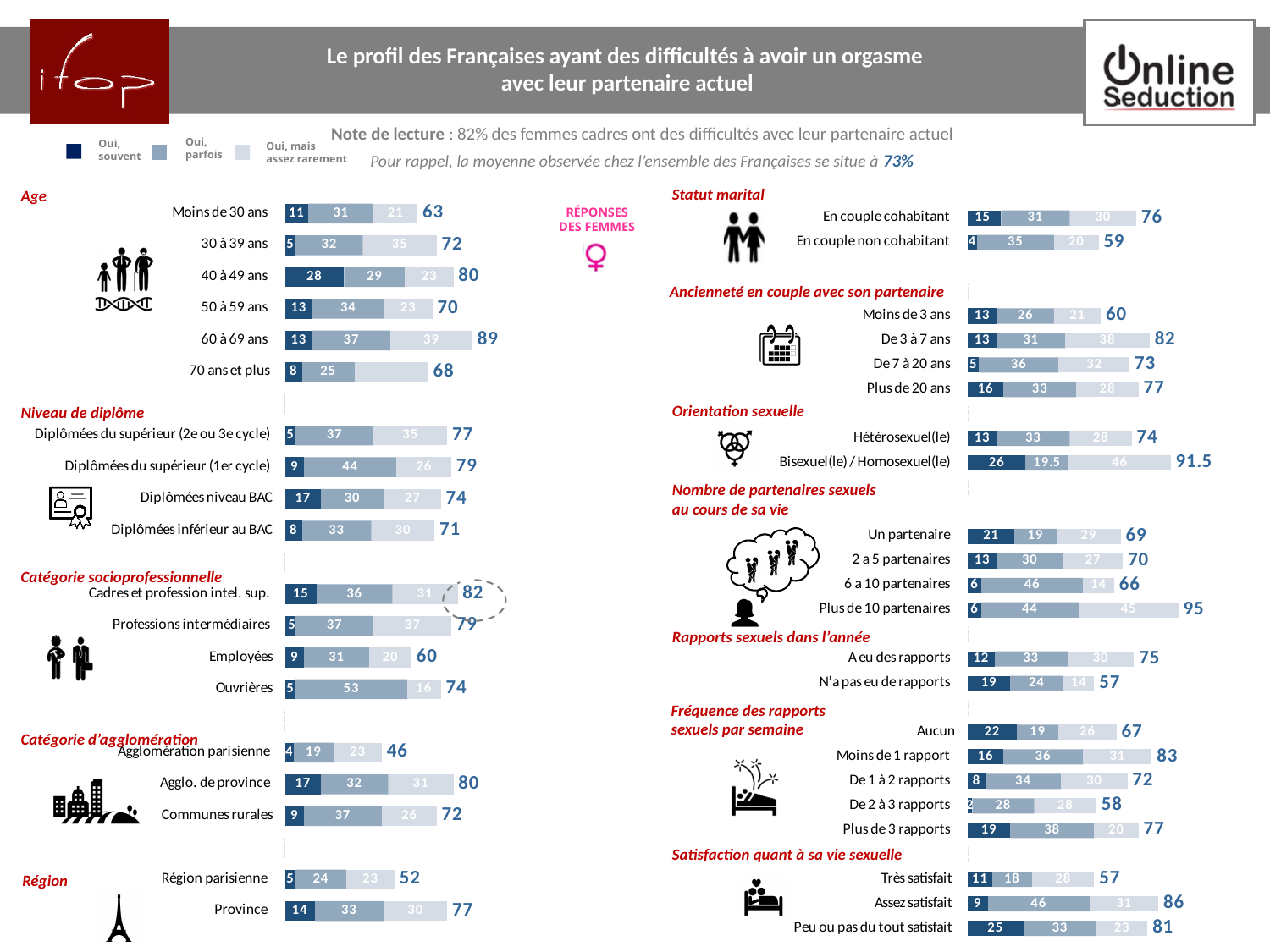
In the 'Catégorie socioprofessionnelle' chart, which category has the lowest total? Employées In the 'Statut marital' chart, which has the larger total: 'En couple cohabitant' or 'En couple non cohabitant'? En couple cohabitant How many age categories are plotted in the 'Age' chart? 6 In the 'Catégorie socioprofessionnelle' chart, what is the 'Oui, parfois' value for 'Ouvrières'? 53 In the 'Nombre de partenaires sexuels au cours de sa vie' chart, which category has the highest total? Plus de 10 partenaires In the 'Orientation sexuelle' chart, what is the total for 'Bisexuel(le) / Homosexuel(le)'? 91.5 In the 'Age' chart, which age group has the lowest total? Moins de 30 ans In the 'Région' chart, what is the difference between the totals for 'Province' and 'Région parisienne'? 25 In the 'Fréquence des rapports sexuels par semaine' chart, which category has the lowest total? De 2 à 3 rapports In the 'Age' chart, what is the total value shown for '60 à 69 ans'? 89 How many series does the legend at the top of the slide list? 3 In the 'Age' chart, what is the 'Oui, souvent' value for '40 à 49 ans'? 28